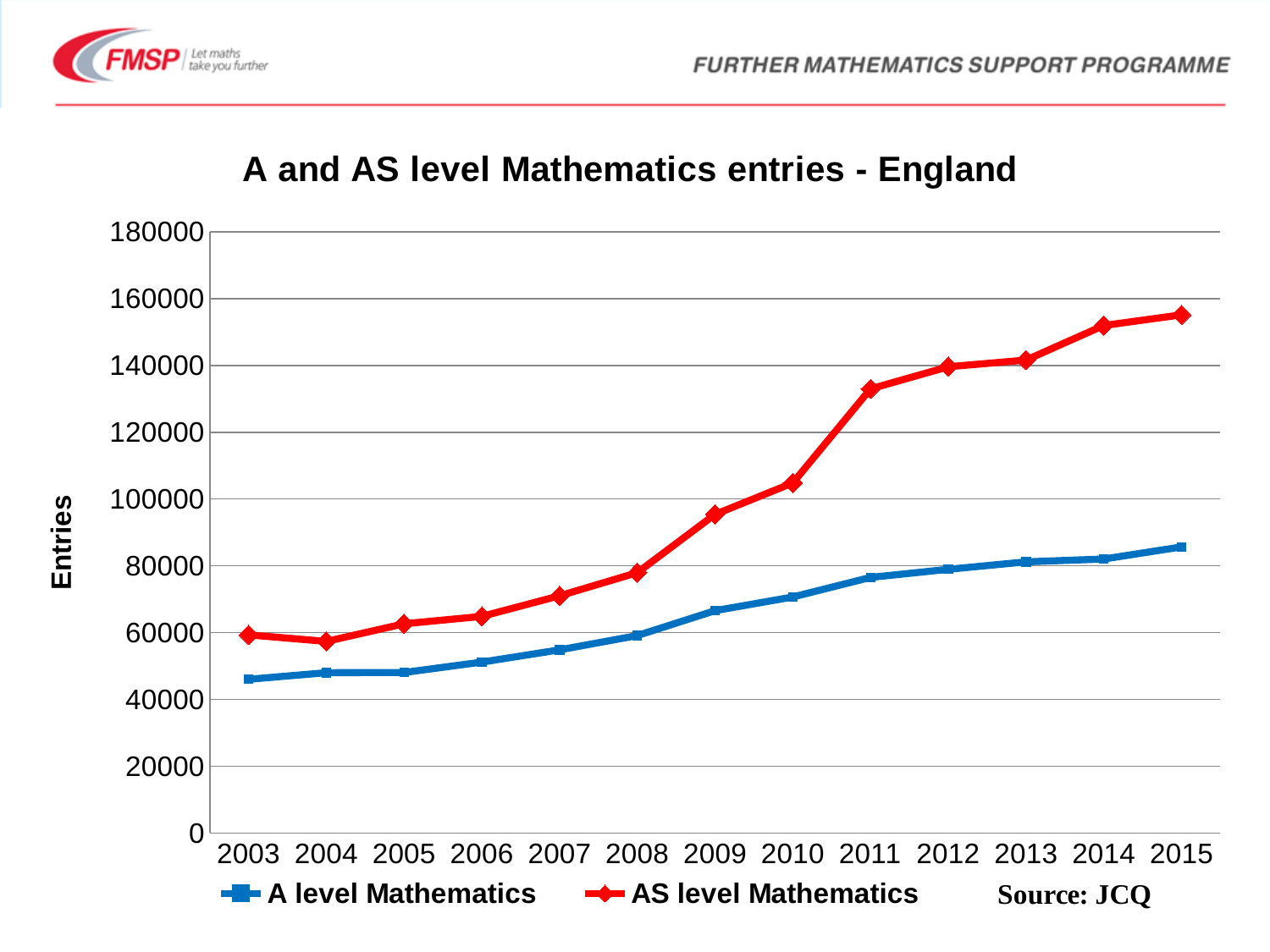
Which year has the lowest value for A level Mathematics? 2003 Which year has the highest value for AS level Mathematics? 2015 Which year has the lowest value for AS level Mathematics? 2004 What is the title of the chart? A and AS level Mathematics entries - England Which series has the larger value in 2011, A level Mathematics or AS level Mathematics? AS level Mathematics What type of chart is shown on the slide? line chart How many years are shown on the x axis? 13 Is the value for A level Mathematics in 2003 greater or less than 60000? less How many series does the legend list? 2 Is the value for AS level Mathematics in 2015 greater or less than 140000? greater Is the value for AS level Mathematics in 2010 greater or less than 100000? greater Do the values for A level Mathematics generally rise or fall from 2003 to 2015? rise